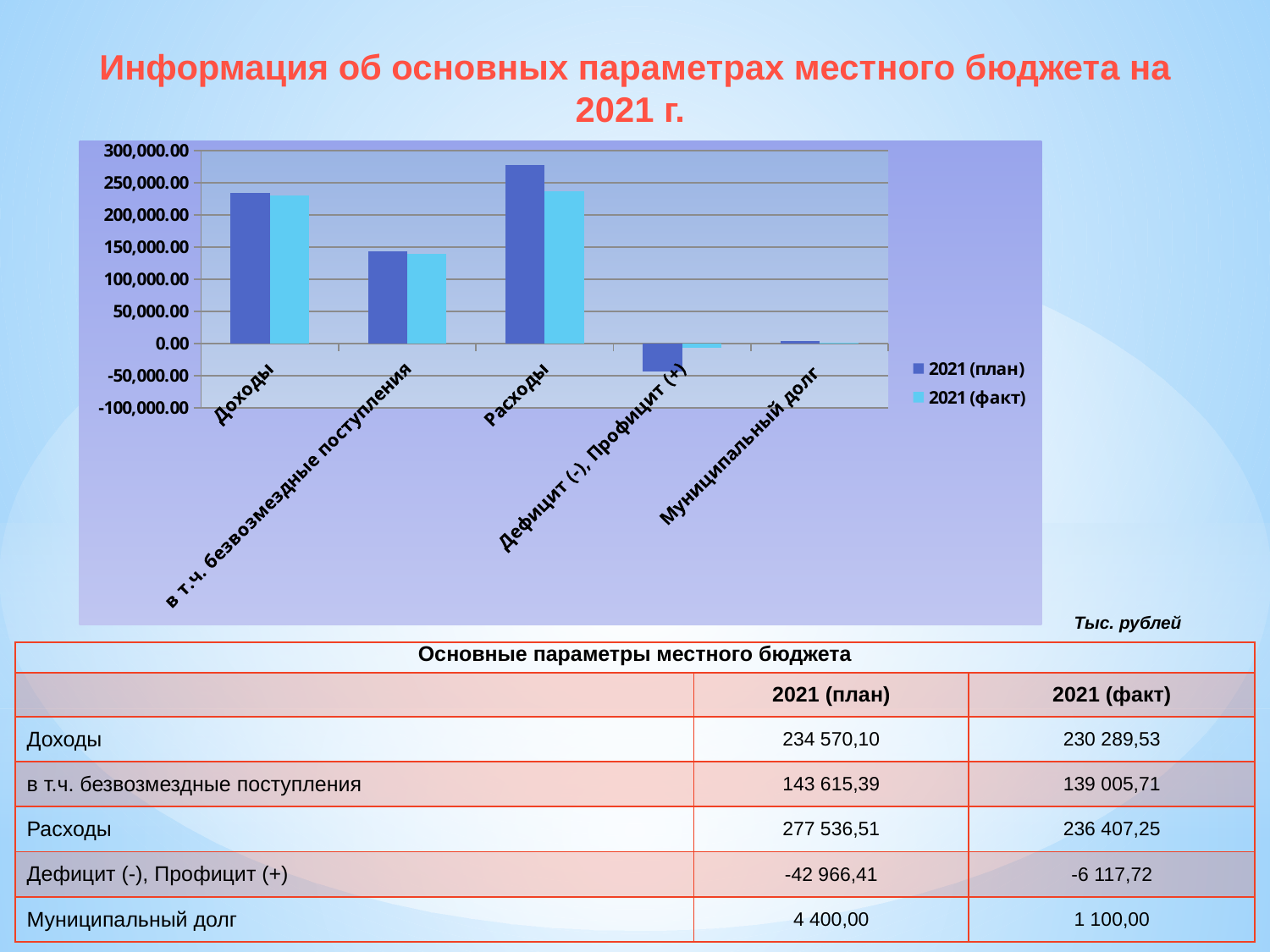
Which is larger for Расходы: the 2021 (план) value or the 2021 (факт) value? 2021 (план) How many categories are shown on the x axis of the chart? 5 Is the 2021 (план) value for Расходы greater or less than 250,000.00? greater Which category has the lowest value for the 2021 (план) series? Дефицит (-), Профицит (+) Which category has the highest value for the 2021 (план) series? Расходы According to the table on the slide, what is the 2021 (факт) value for Дефицит (-), Профицит (+)? -6 117,72 What are the two legend entries of the chart? 2021 (план) and 2021 (факт) What kind of chart is shown on the slide? bar chart Is the 2021 (факт) value for в т.ч. безвозмездные поступления greater or less than 150,000.00? less According to the table on the slide, what is the 2021 (факт) value for Муниципальный долг? 1 100,00 How many series does the chart legend list? 2 According to the table on the slide, what is the 2021 (план) value for Доходы? 234 570,10